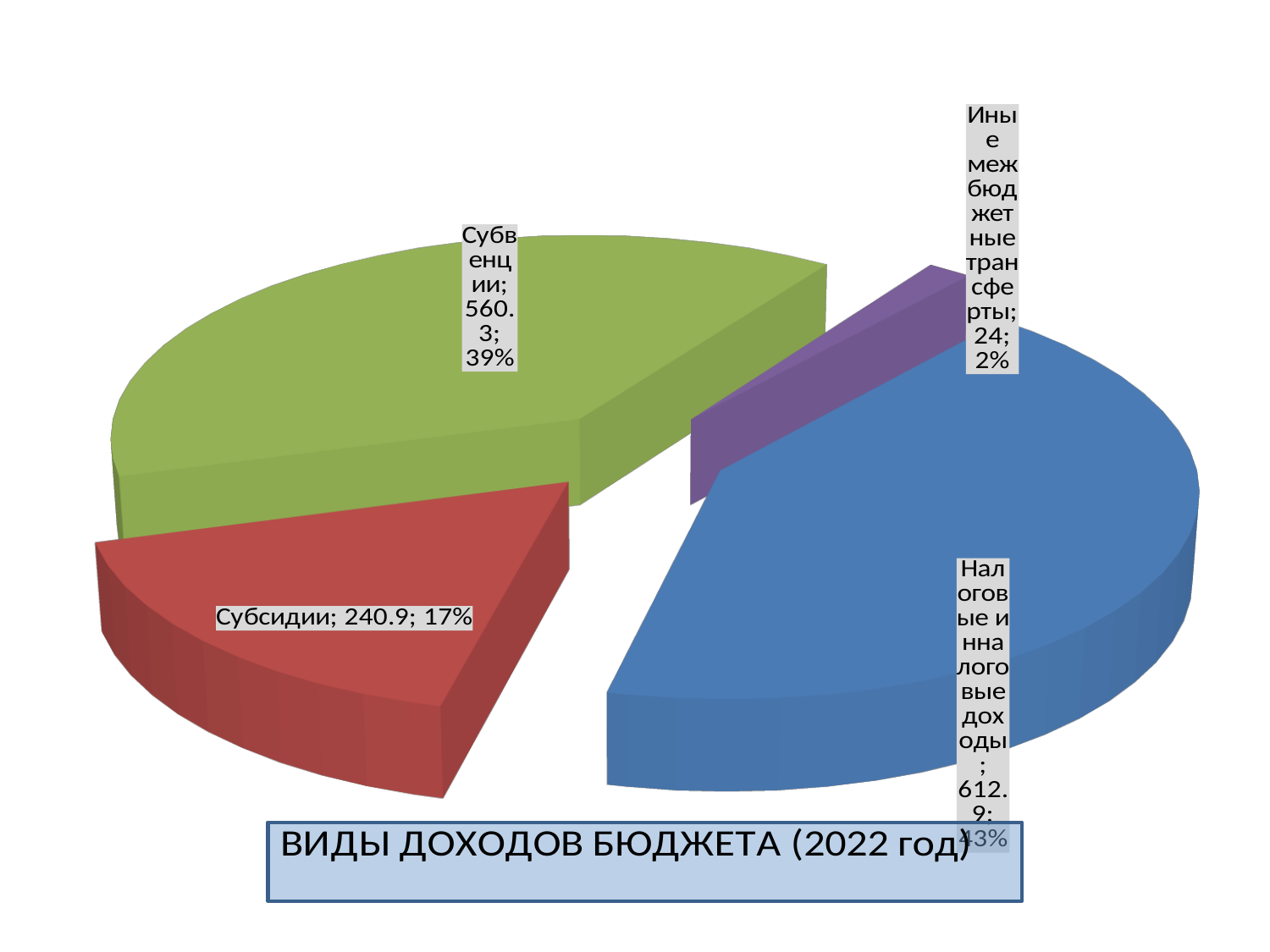
What share of the pie does Субсидии represent? 17% Which category has the smallest slice? Иные межбюджетные трансферты What share of the pie does Субвенции represent? 39% What is the value for Налоговые и неналоговые доходы? 612.9 How many slices does the pie chart have? 4 What is the difference between the values for Субвенции and Субсидии? 319.4 What is the value for Иные межбюджетные трансферты? 24 What is the title of the chart? ВИДЫ ДОХОДОВ БЮДЖЕТА (2022 год) Which category has the largest slice? Налоговые и неналоговые доходы What kind of chart is shown on the slide? Pie chart What is the value for Субсидии? 240.9 What is the value for Субвенции? 560.3